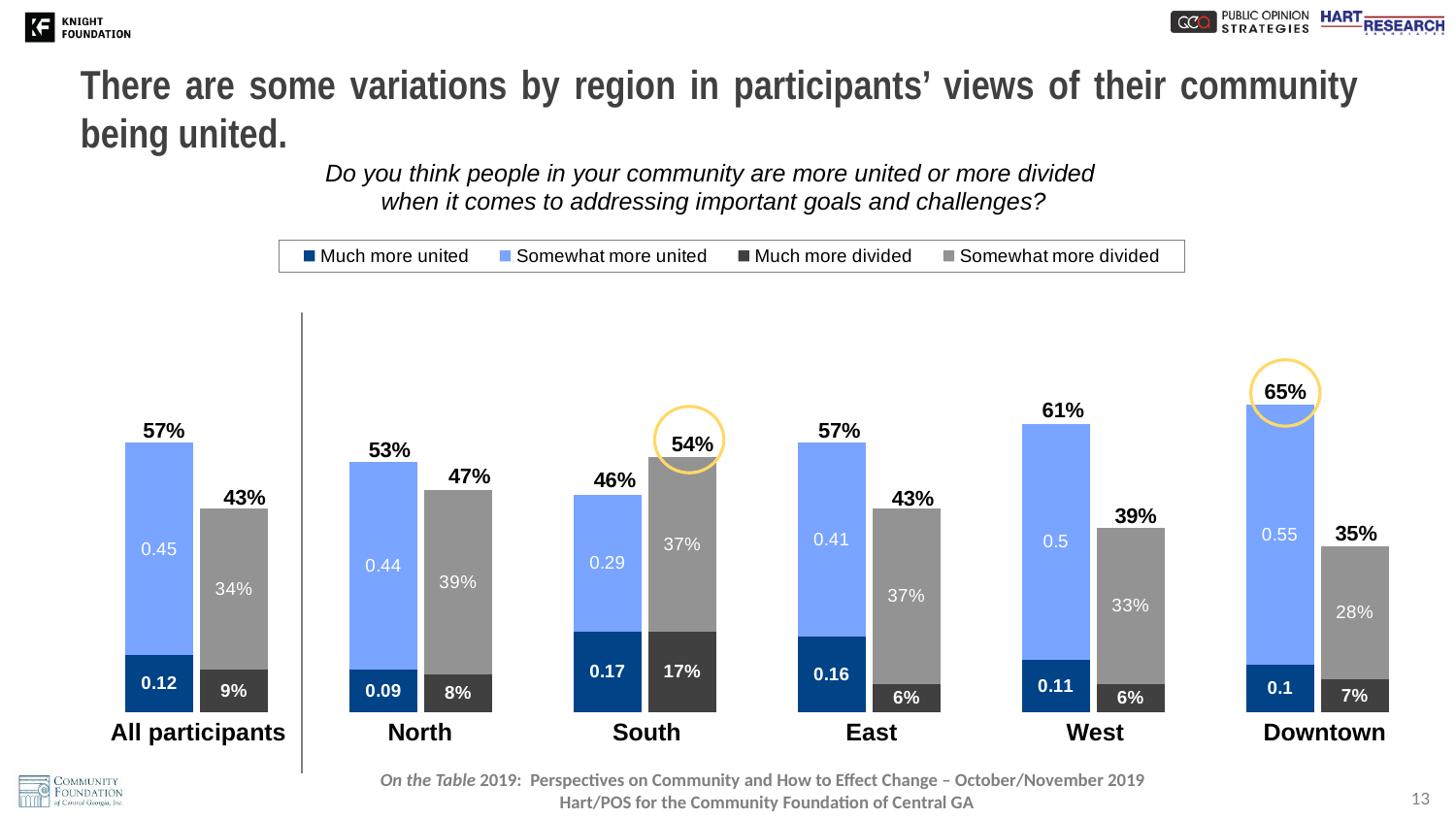
What kind of chart is shown on the slide? Stacked bar chart What is the 'Much more divided' value for All participants? 9% Which region has the highest total for the 'more united' bar? Downtown Is the 'more divided' total larger for the North or for the East? North How many series does the legend list? 4 What is the total of the 'more divided' stacked bar for the South? 54% Which region has the lowest total for the 'more united' bar? South What is the 'Somewhat more divided' value for the South? 37% What is the difference between the united total and the divided total for the West? 22% Which legend entry is shown in the light blue colour? Somewhat more united How many region categories are shown on the x axis, including All participants? 6 What is the total percentage of participants who say their community is more united (the united bar) for Downtown? 65%